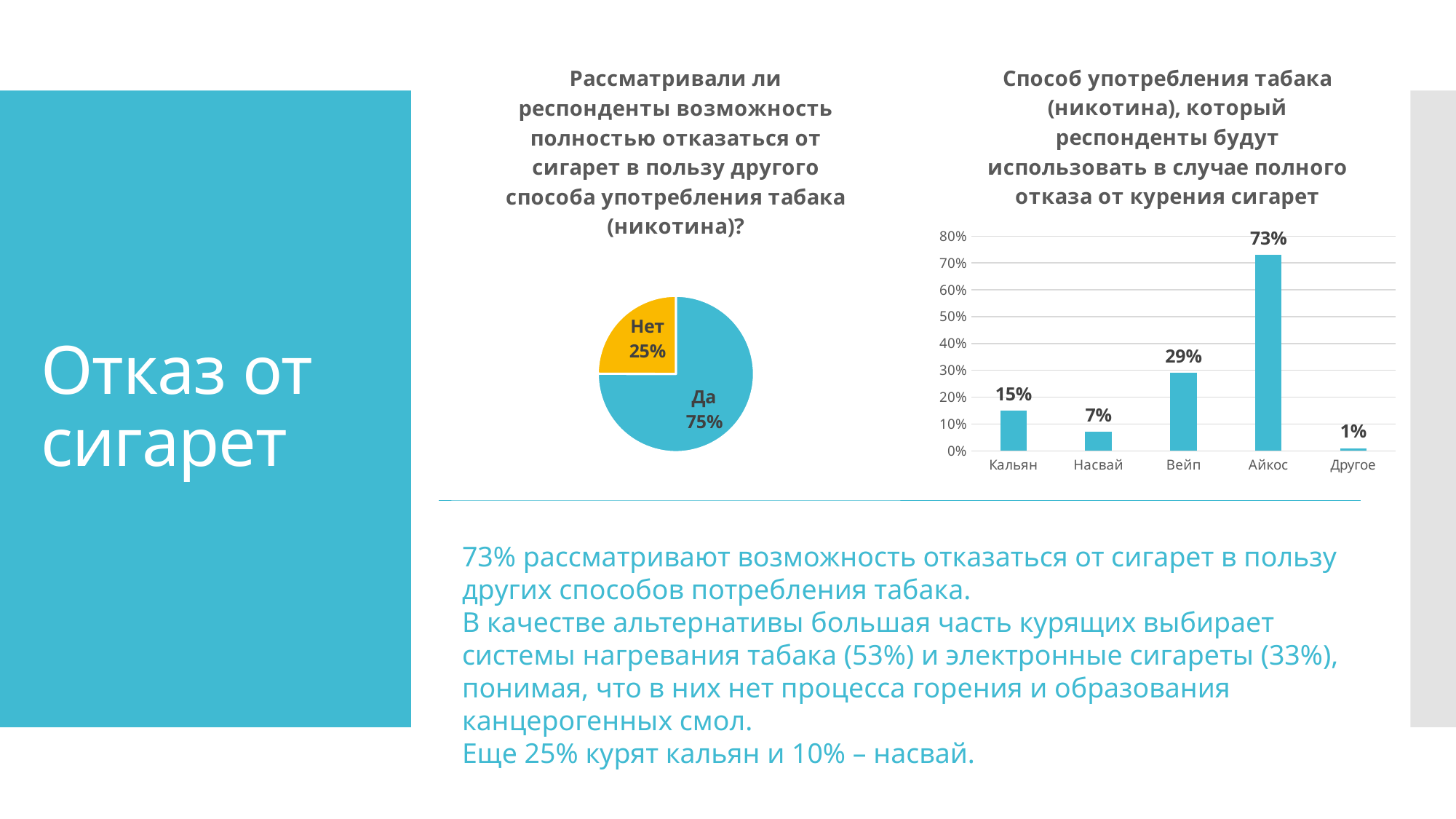
In the pie chart on the left, what share of respondents answered "Нет"? 25% How many categories are shown on the x axis of the bar chart on the right? 5 In the bar chart on the right, which category has the lowest value? Другое In the bar chart on the right, which is larger: the value for Кальян or the value for Насвай? Кальян What kind of chart is the chart on the right of the slide? Bar chart In the bar chart on the right, which category has the highest value? Айкос In the pie chart on the left, what share of respondents answered "Да"? 75% In the bar chart on the right, what is the value for Вейп? 29% In the bar chart on the right, what is the value for Айкос? 73% In the bar chart on the right, what is the difference between the values for Айкос and Вейп? 44% In the bar chart on the right, what is the value for Насвай? 7% What kind of chart is the chart on the left of the slide? Pie chart